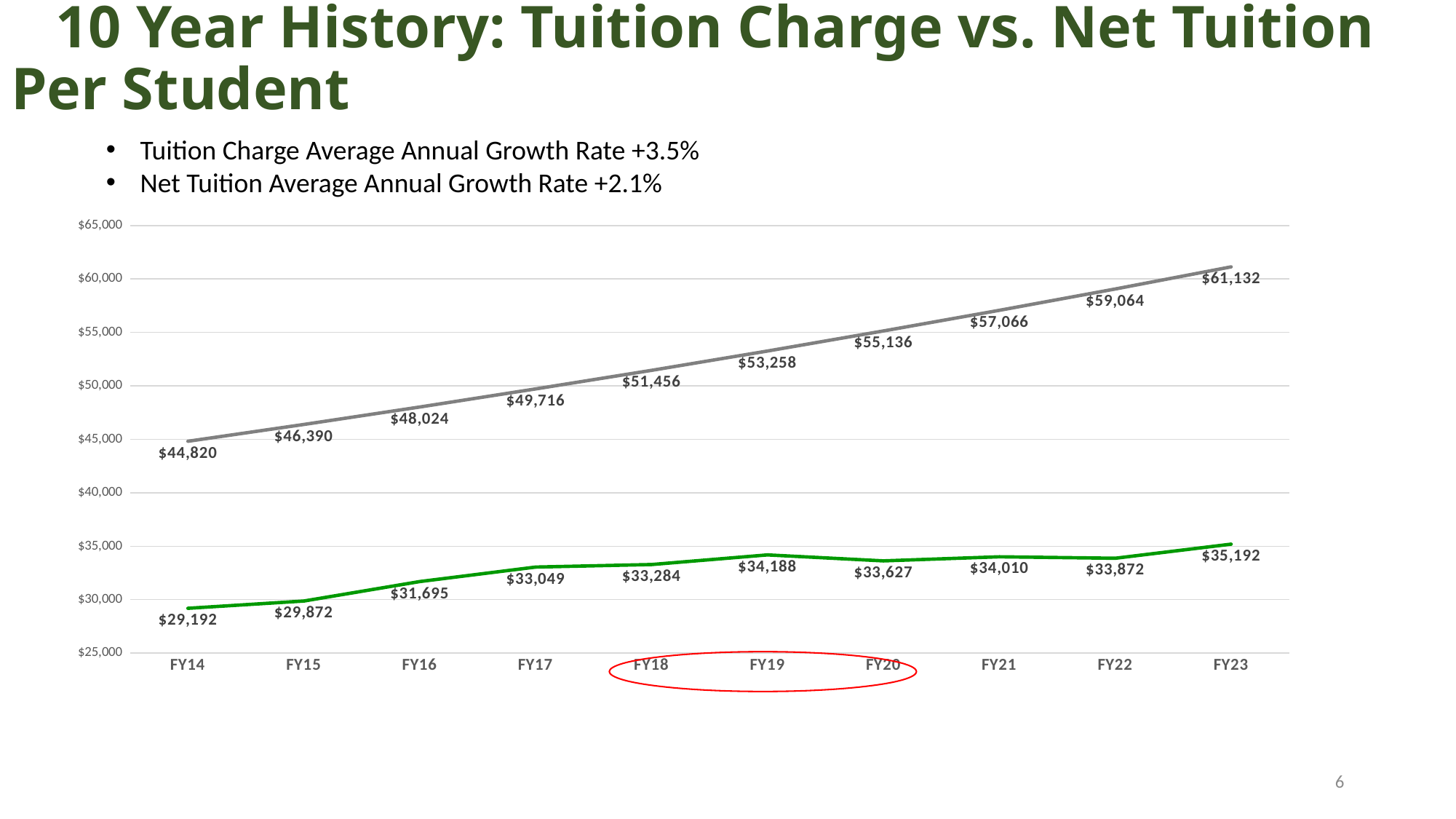
Which is larger for the lower green line (Net Tuition): the FY19 value or the FY20 value? FY19 In which fiscal year does the upper gray line (Tuition Charge) reach its highest value? FY23 How many fiscal years are plotted along the x axis? 10 Which fiscal years on the x axis are circled in red? FY18, FY19, FY20 What is the value of the lower green line (Net Tuition) for FY23? $35,192 What type of chart is shown on the slide? Line chart What is the difference between the Tuition Charge and Net Tuition values in FY23? $25,940 Does the upper gray line (Tuition Charge) rise or fall from FY14 to FY23? Rise What is the value of the upper gray line (Tuition Charge) for FY20? $55,136 In which fiscal year is the lower green line (Net Tuition) at its lowest value? FY14 What is the value of the upper gray line (Tuition Charge) for FY14? $44,820 What is the value of the lower green line (Net Tuition) for FY19? $34,188